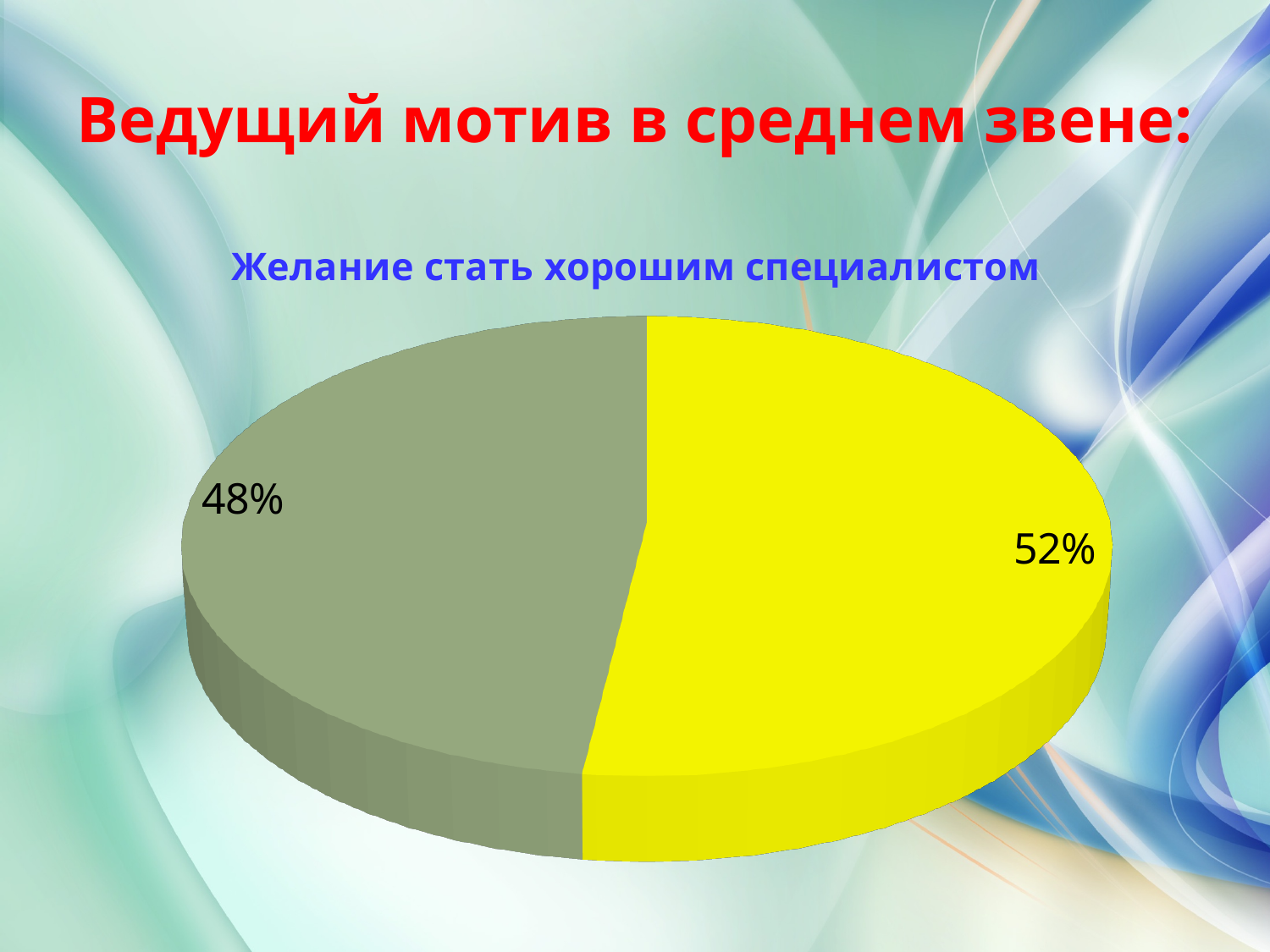
What colour is the slice labelled 52%? yellow Which slice of the pie chart is the largest, the yellow one or the grey one? the yellow one How many slices does the pie chart have? 2 Is the value of the grey slice greater or less than 50%? less Which slice of the pie chart is the smallest, the yellow one or the grey one? the grey one What is the total of the two slices shown on the pie chart? 100% What percentage is shown on the yellow slice of the pie chart? 52% What is the difference in percentage points between the yellow slice and the grey slice? 4 What is the title of the chart? Желание стать хорошим специалистом What percentage is shown on the grey slice of the pie chart? 48% What kind of chart is shown on the slide? pie chart Is the value of the yellow slice greater or less than 50%? greater